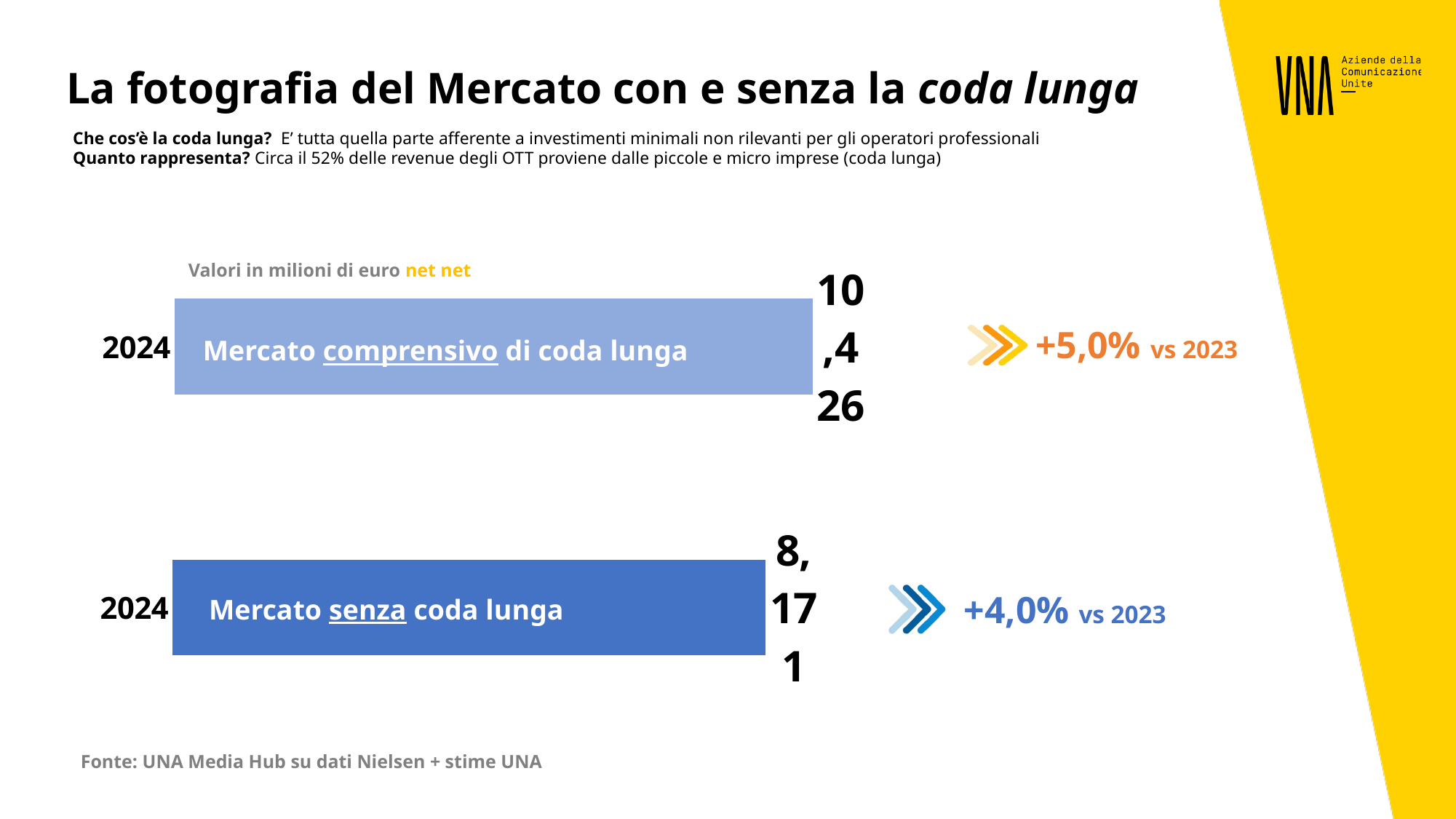
What kind of chart is shown on the slide? bar chart Which bar is the lowest? Mercato senza coda lunga What growth vs 2023 is shown next to the "Mercato senza coda lunga" bar? +4,0% How many bars does the chart show? 2 Which bar is the highest? Mercato comprensivo di coda lunga What is the value for "Mercato senza coda lunga" in 2024? 8,171 What is the difference between the value for "Mercato comprensivo di coda lunga" and the value for "Mercato senza coda lunga"? 2,255 In what unit are the chart values expressed, according to the note above the bars? milioni di euro net net Which is larger, the value for "Mercato comprensivo di coda lunga" or for "Mercato senza coda lunga"? Mercato comprensivo di coda lunga Which year do both bars refer to? 2024 What is the value for "Mercato comprensivo di coda lunga" in 2024? 10,426 What growth vs 2023 is shown next to the "Mercato comprensivo di coda lunga" bar? +5,0%